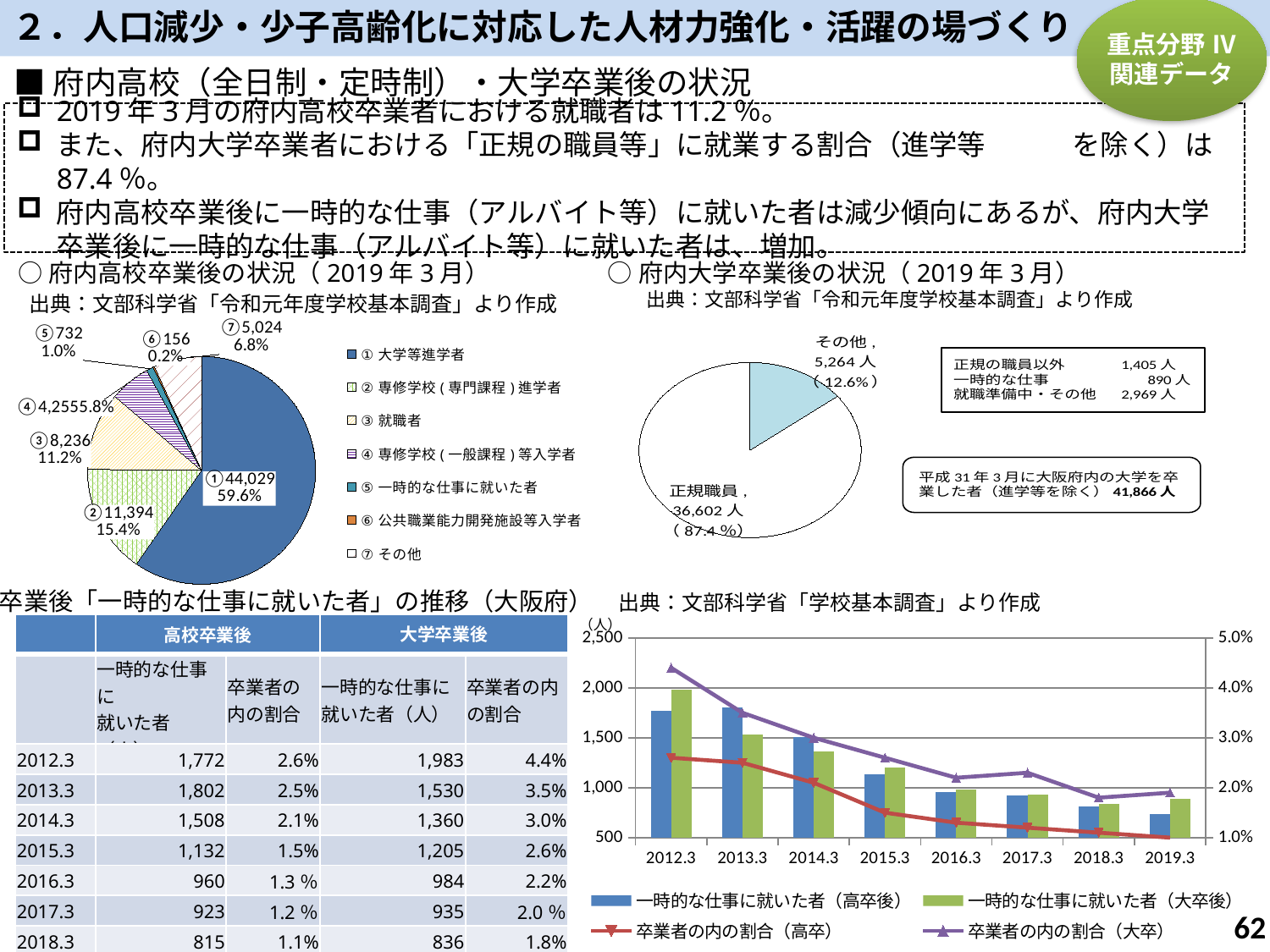
In the bottom-right chart, how many series does the legend list? 4 In the pie chart titled 府内高校卒業後の状況（2019年3月）, how many people are shown for ② 専修学校（専門課程）進学者? 11,394 In the pie chart titled 府内大学卒業後の状況（2019年3月）, what percentage is shown for 正規職員? 87.4% In the pie chart titled 府内大学卒業後の状況（2019年3月）, what is the difference in number of people between 正規職員 and その他? 31,338人 In the bottom-right chart, do the bars for 一時的な仕事に就いた者（高卒後） generally rise or fall from 2012.3 to 2019.3? fall In the pie chart titled 府内高校卒業後の状況（2019年3月）, which category has the smallest share? ⑥ 公共職業能力開発施設等入学者 What kind of chart is the chart at the bottom right of the slide showing 2012.3 to 2019.3? Combined bar and line chart In the bottom-right chart, is the bar for 一時的な仕事に就いた者（高卒後） in 2019.3 greater or less than 1,000? less In the pie chart titled 府内高校卒業後の状況（2019年3月）, how many categories does the legend list? 7 In the pie chart titled 府内高校卒業後の状況（2019年3月）, which is larger: ③ 就職者 or ⑦ その他? ③ 就職者 In the pie chart titled 府内高校卒業後の状況（2019年3月）, what percentage is shown for ① 大学等進学者? 59.6% In the pie chart titled 府内大学卒業後の状況（2019年3月）, how many people are shown for その他? 5,264人